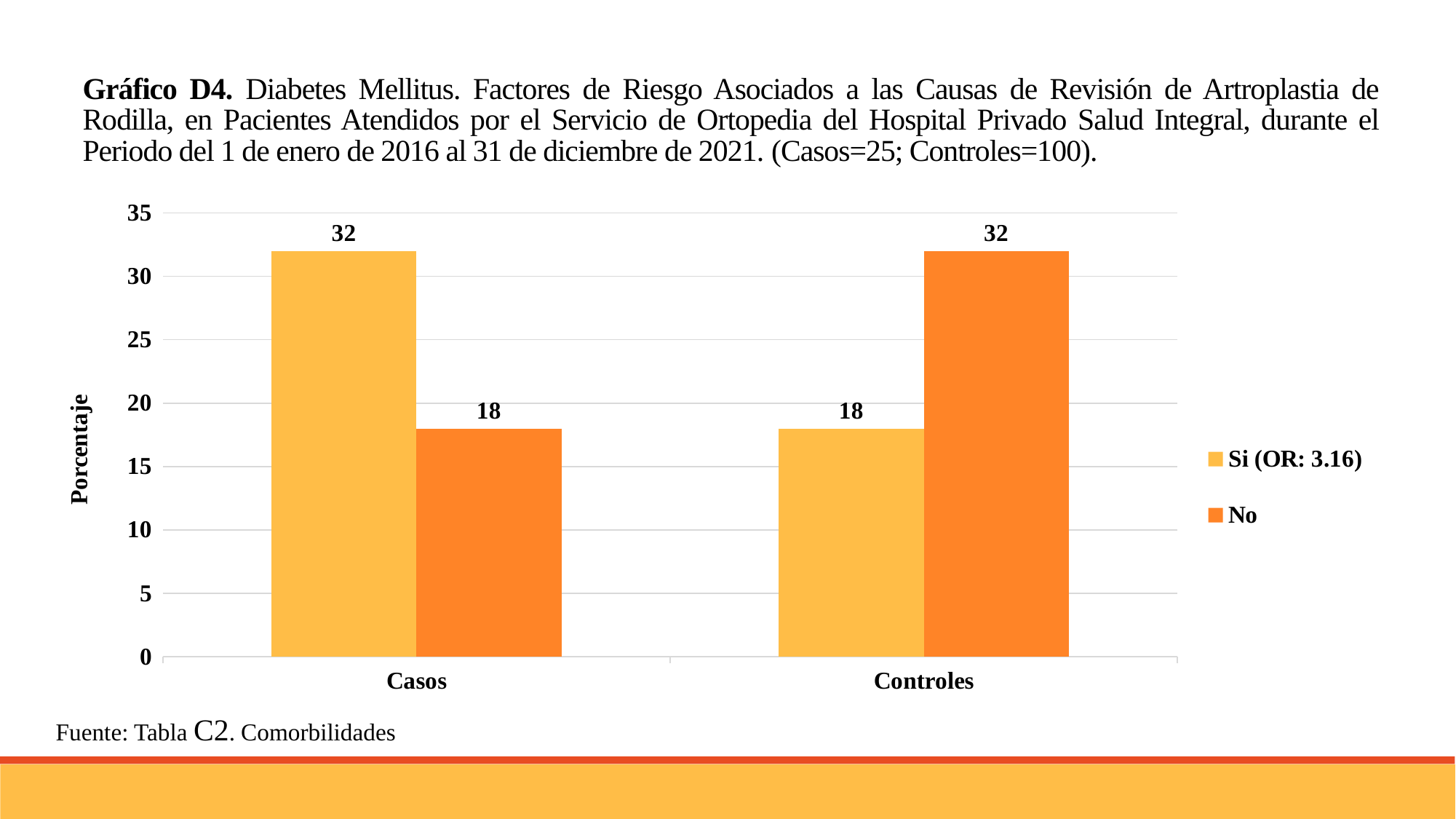
How many series does the legend list? 2 How many categories are shown on the x axis? 2 What is the value for "Si (OR: 3.16)" in the Casos category? 32 Which series has the lower value in the Controles category? Si (OR: 3.16) What is the value for "Si (OR: 3.16)" in the Controles category? 18 What is the difference between the "Si (OR: 3.16)" and "No" values in the Casos category? 14 Which is larger: the "No" value for Casos or the "No" value for Controles? Controles What is the value for "No" in the Controles category? 32 What is the label of the vertical axis? Porcentaje What kind of chart is shown on the slide? Bar chart Which series has the higher value in the Casos category? Si (OR: 3.16) What is the value for "No" in the Casos category? 18